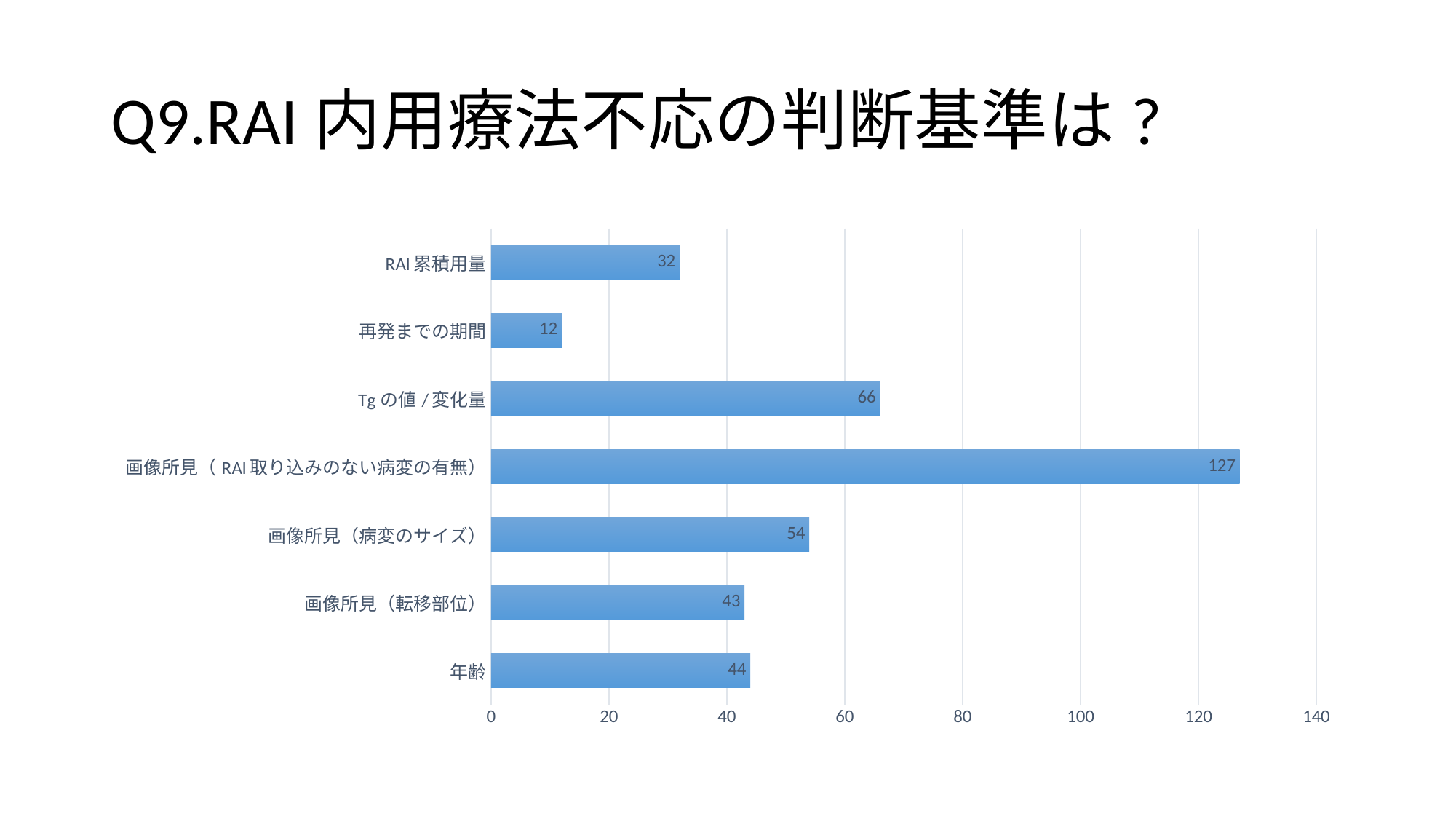
What is the value for 画像所見（RAI取り込みのない病変の有無）? 127 What is the value for 年齢? 44 How many categories are shown in the chart? 7 Which category has the highest value? 画像所見（RAI取り込みのない病変の有無） Which is larger, the value for 画像所見（病変のサイズ） or the value for RAI累積用量? 画像所見（病変のサイズ） What is the difference between the values for 画像所見（RAI取り込みのない病変の有無） and Tgの値/変化量? 61 Is the value for 画像所見（転移部位） greater or less than 60? less What is the value for 再発までの期間? 12 What kind of chart is shown on the slide? bar chart Which category has the lowest value? 再発までの期間 What is the value for Tgの値/変化量? 66 What is the title of the slide? Q9.RAI内用療法不応の判断基準は？